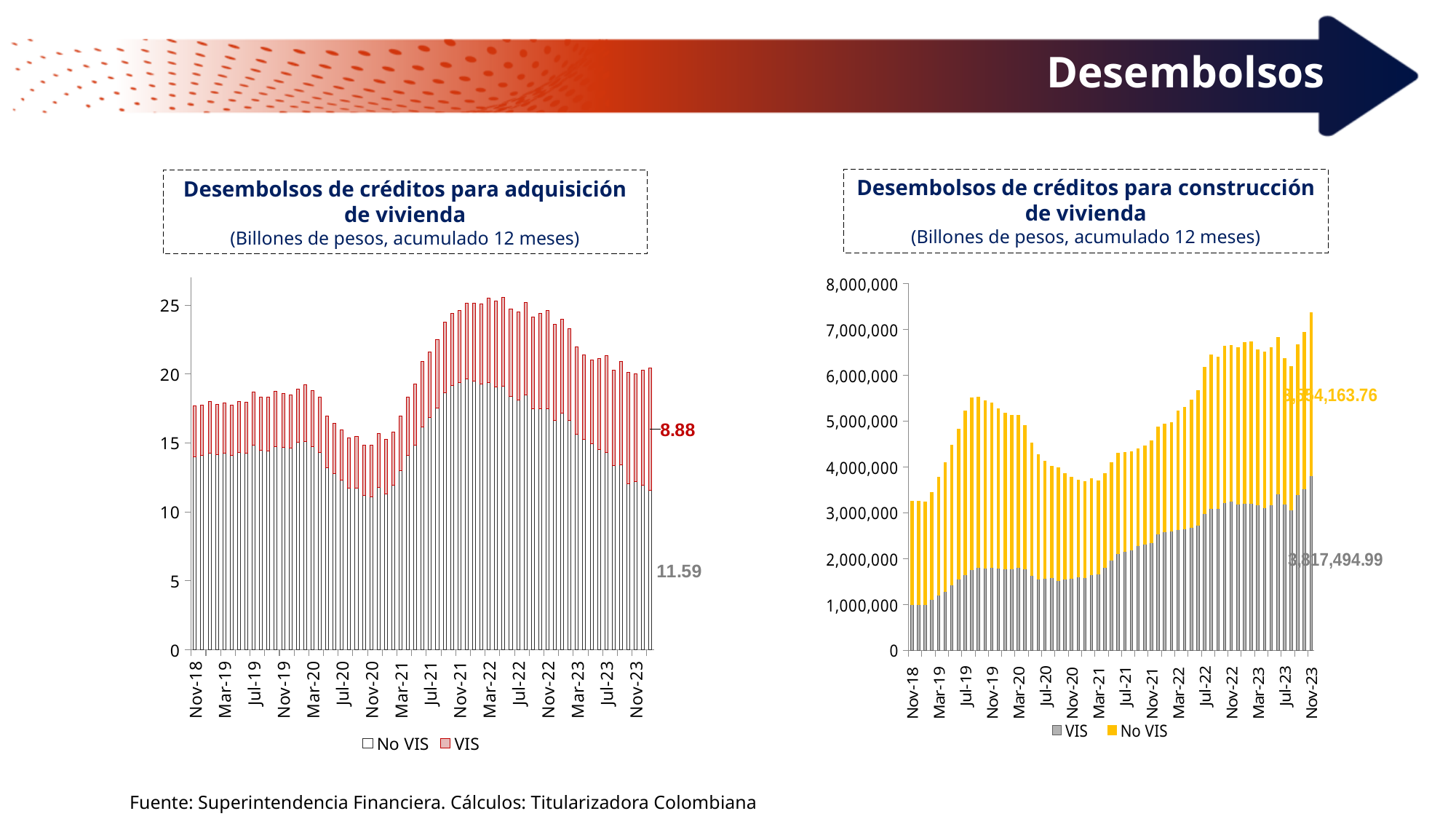
In the right chart (construcción de vivienda), is the total bar for Nov-18 greater or less than 4,000,000? less In the left chart (adquisición de vivienda), what is the No VIS value labelled for Nov-23? 11.59 What kind of chart is the right chart, 'Desembolsos de créditos para construcción de vivienda'? Bar chart In the right chart (construcción de vivienda), is the total bar for Nov-23 greater or less than 7,000,000? greater How many series does the legend of the left chart (adquisición de vivienda) list? 2 What kind of chart is the left chart, 'Desembolsos de créditos para adquisición de vivienda'? Bar chart In the left chart (adquisición de vivienda), what is the VIS value labelled for Nov-23? 8.88 In the left chart (adquisición de vivienda), what is the total of the Nov-23 stacked bar (No VIS plus VIS)? 20.47 In the left chart (adquisición de vivienda), which series is shown in red? VIS What are the legend entries of the right chart (construcción de vivienda)? VIS, No VIS In the left chart (adquisición de vivienda), which series is larger at Nov-23, No VIS or VIS? No VIS In the left chart (adquisición de vivienda), is the total bar for Nov-20 greater or less than 20? less